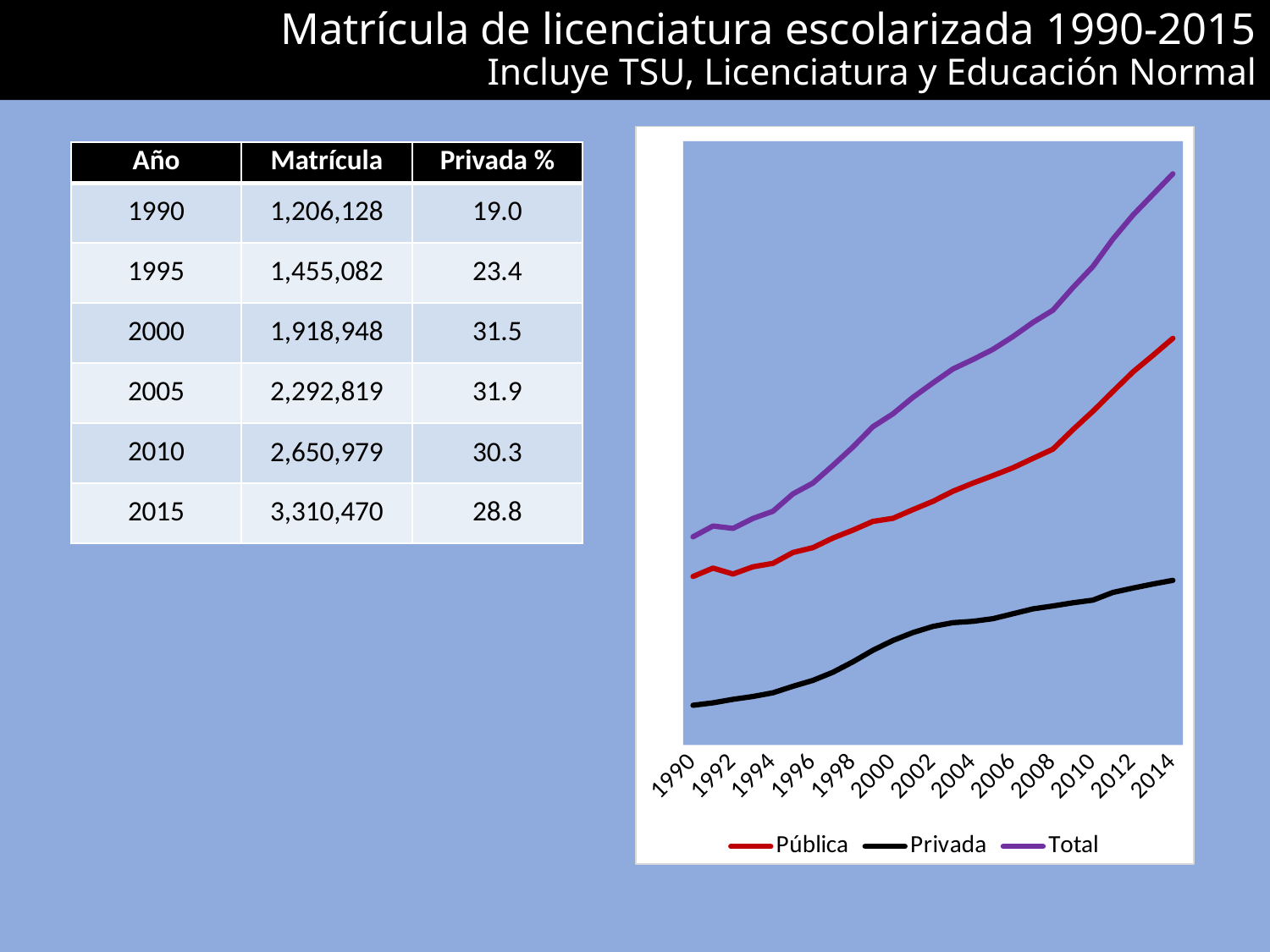
Does the Total series in the line chart rise or fall from 1990 to 2014? Rise In the line chart, which series is larger in 2000, Total or Pública? Total In the line chart, which series is larger in 2014, Pública or Privada? Pública How many year labels are shown on the x axis of the line chart? 13 Which series in the line chart has the lowest values throughout the period? Privada What is the first year labelled on the x axis of the line chart? 1990 How many series does the legend of the line chart list? 3 Which series in the line chart has the highest values throughout the period? Total What are the names of the series in the line chart's legend? Pública, Privada, Total Does the Privada series in the line chart rise or fall over the period shown? Rise Which series in the line chart is drawn in red? Pública What kind of chart is shown on the right side of the slide? Line chart